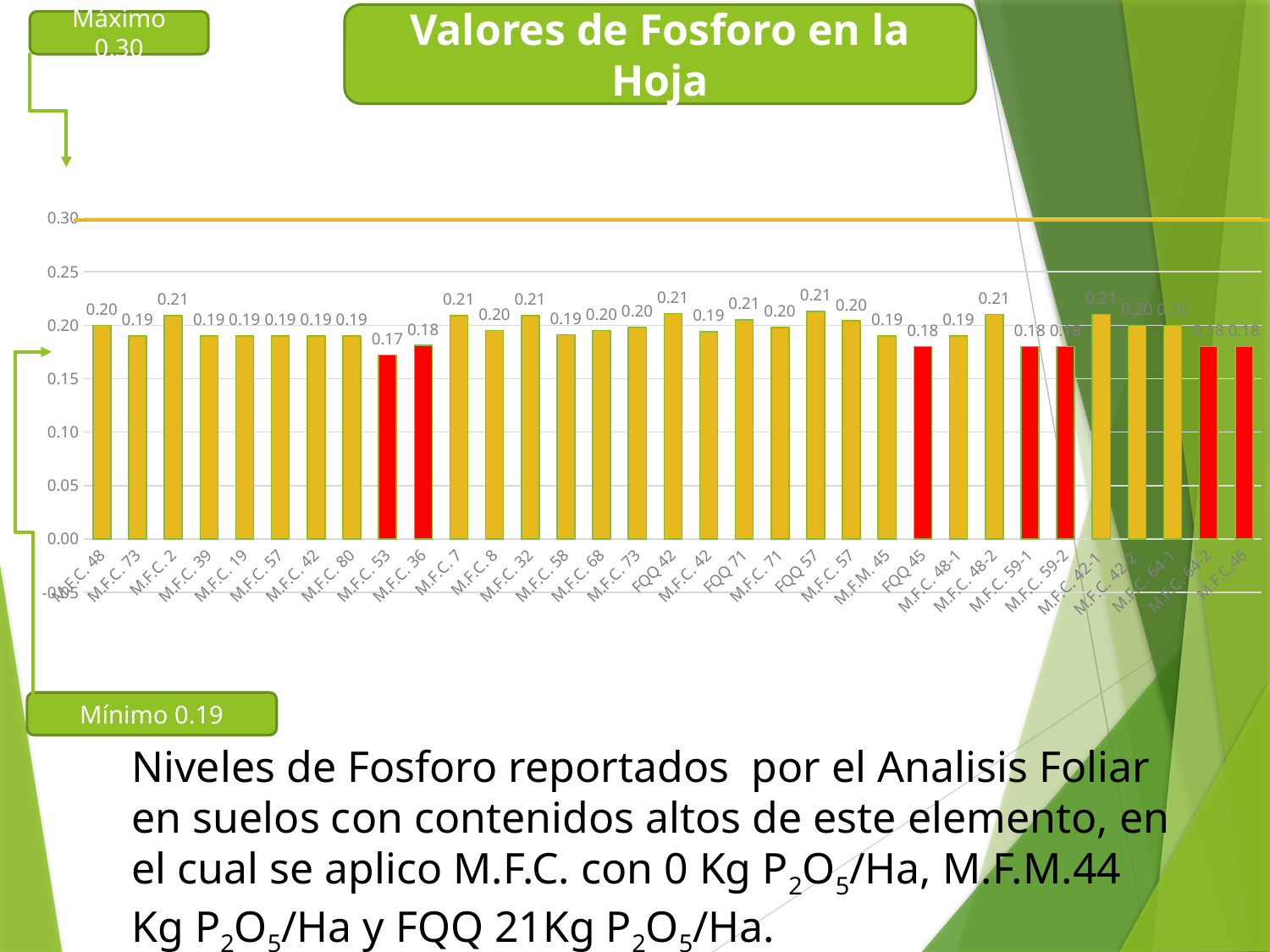
Which is larger, the value for M.F.C. 7 or the value for M.F.C. 36? M.F.C. 7 What is the value for FQQ 45? 0.18 What colour is the bar for M.F.C. 53? red What is the value for M.F.C. 48? 0.20 What is the difference between the values for M.F.C. 2 and M.F.C. 53? 0.04 What is the title of the chart? Valores de Fosforo en la Hoja Is the value for M.F.C. 36 greater or less than 0.20? less What is the value for M.F.C. 2? 0.21 Which category has the lowest value? M.F.C. 53 What kind of chart is shown on the slide? bar chart What is the value for M.F.M. 45? 0.19 What is the value for M.F.C. 53? 0.17